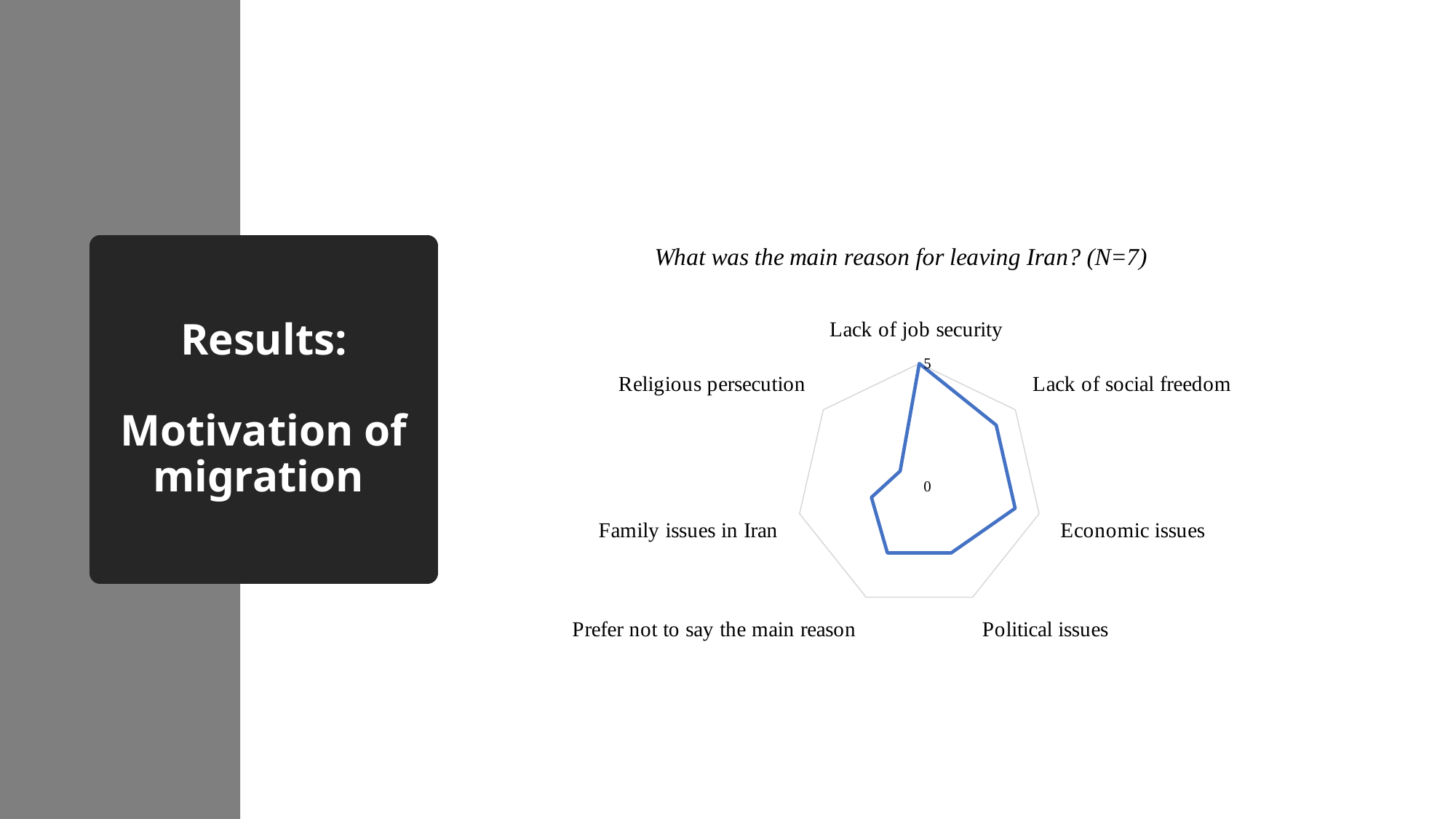
What is the maximum value shown on the chart's axis scale? 5 Which has a larger value, Economic issues or Family issues in Iran? Economic issues Which reason has the lowest value on the chart? Religious persecution What is the value for Lack of job security? 5 What type of chart is shown on the slide? Radar chart How many categories (reasons) are plotted on the radar chart? 7 What is the title of the chart? What was the main reason for leaving Iran? (N=7) Which reason has the highest value on the chart? Lack of job security Which has a larger value, Lack of social freedom or Religious persecution? Lack of social freedom What is the sample size (N) stated in the chart title? 7 Which has a larger value, Lack of job security or Religious persecution? Lack of job security